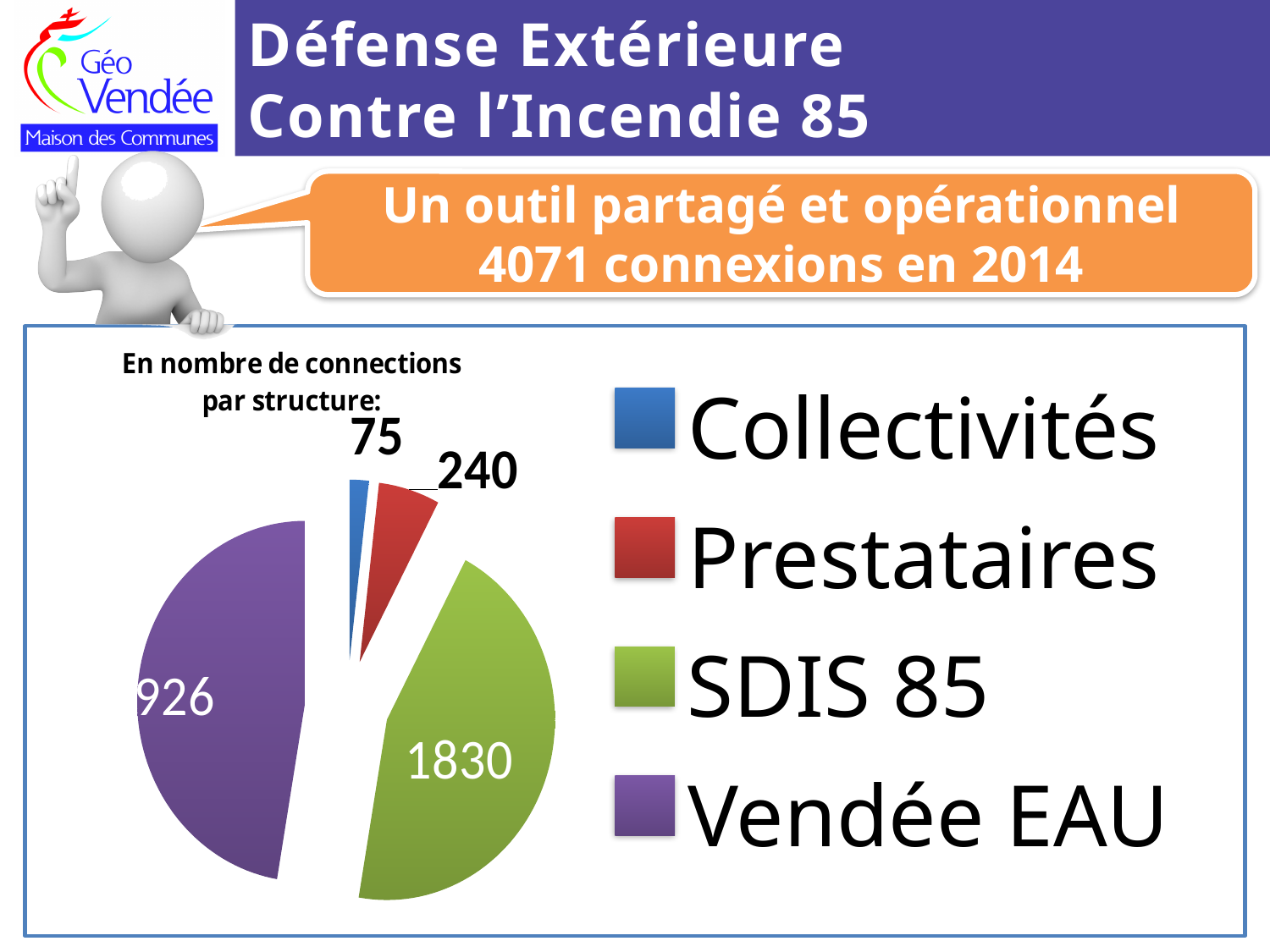
How many structures (slices) does the pie chart show? 4 How many connections are shown for Prestataires? 240 How many connections are shown for SDIS 85? 1830 Which structure has the highest number of connections? Vendée EAU What colour is the slice for SDIS 85? green How many connections are shown for Vendée EAU? 1926 What is the difference in connections between Vendée EAU and SDIS 85? 96 How many connections are shown for Collectivités? 75 Which has more connections, Prestataires or Collectivités? Prestataires What is the difference in connections between Prestataires and Collectivités? 165 Which structure has the lowest number of connections? Collectivités What kind of chart is shown on the slide? pie chart